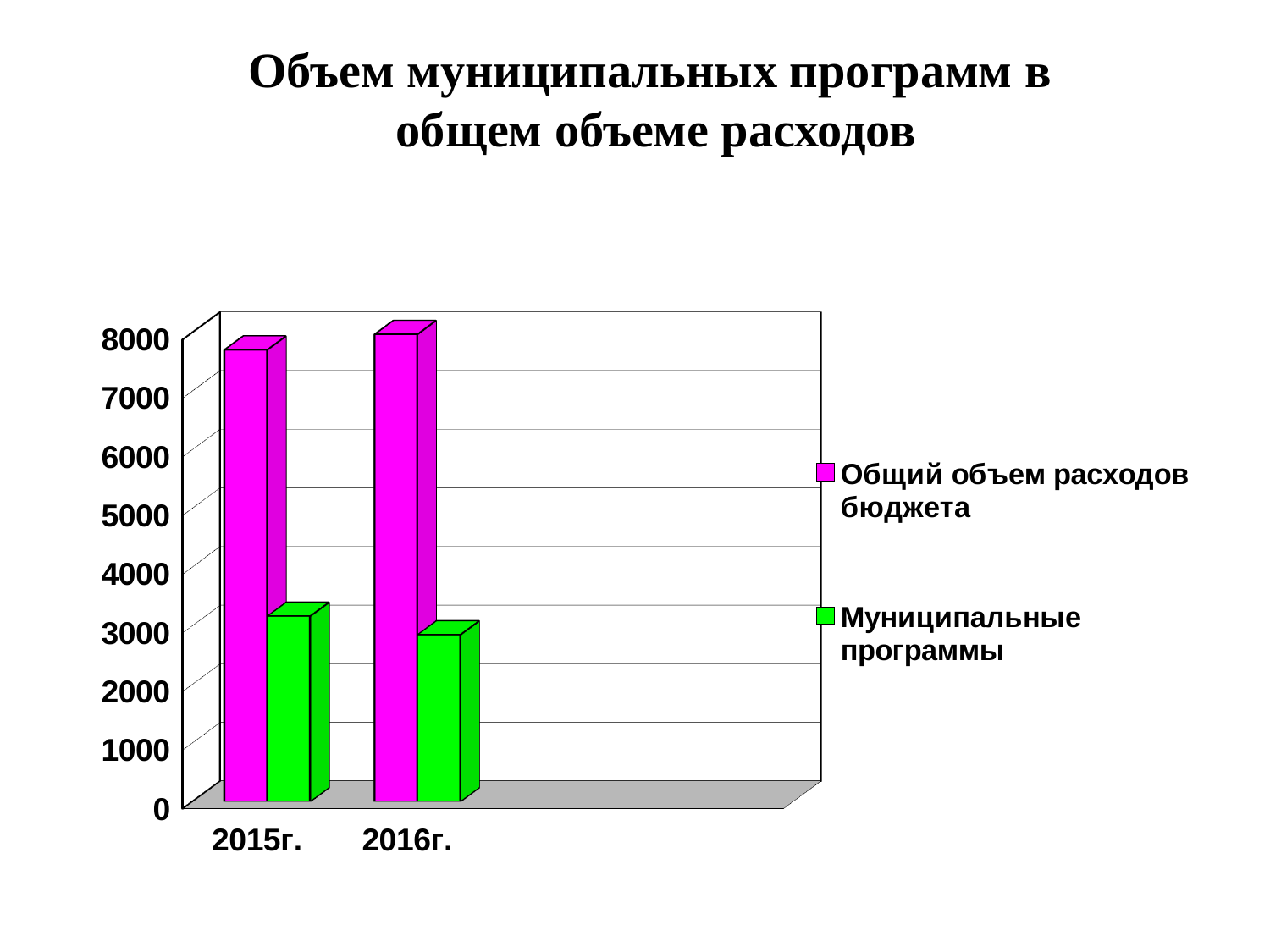
Is the value of "Общий объем расходов бюджета" for 2016г. greater or less than 7000? greater Which year has the higher value for "Общий объем расходов бюджета", 2015г. or 2016г.? 2016г. What is the title of the chart? Объем муниципальных программ в общем объеме расходов Is the value of "Муниципальные программы" for 2016г. greater or less than 2000? greater What kind of chart is shown on the slide? Bar chart How many categories (years) are shown on the x axis? 2 How many series does the legend list? 2 Which year has the lower value for "Муниципальные программы"? 2016г. Is the value of "Общий объем расходов бюджета" for 2015г. greater or less than 7000? greater Which colour represents the series "Муниципальные программы"? Green Does the value of "Муниципальные программы" rise or fall from 2015г. to 2016г.? Fall